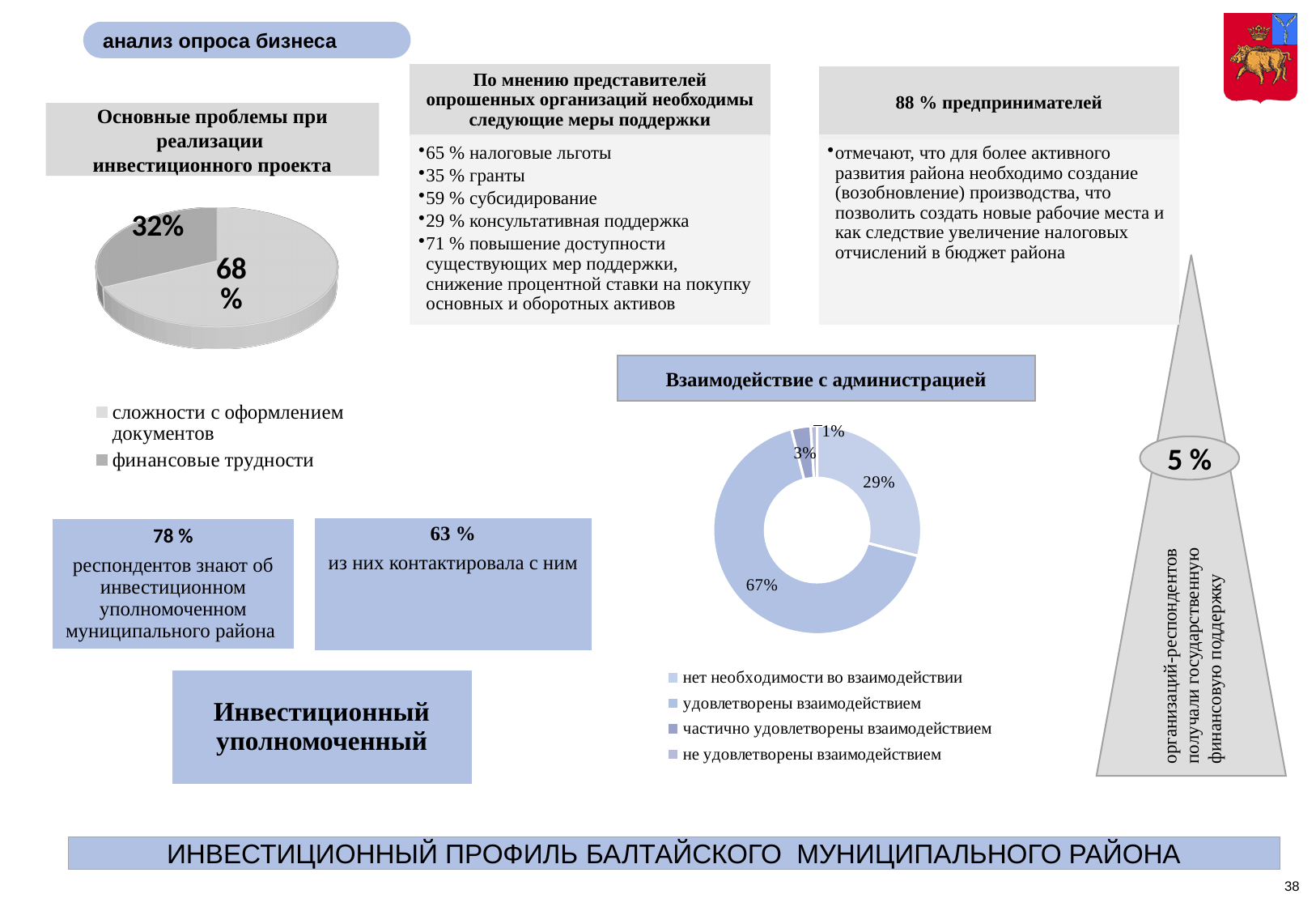
In the pie chart under 'Основные проблемы при реализации инвестиционного проекта', what share is labelled for 'сложности с оформлением документов'? 68% How many slices does the pie chart under 'Основные проблемы при реализации инвестиционного проекта' have? 2 How many categories does the legend of the 'Взаимодействие с администрацией' chart list? 4 In the 'Взаимодействие с администрацией' chart, what percentage is shown for 'нет необходимости во взаимодействии'? 29% In the 'Взаимодействие с администрацией' chart, what percentage is shown for 'частично удовлетворены взаимодействием'? 3% In the 'Взаимодействие с администрацией' chart, what percentage is shown for 'удовлетворены взаимодействием'? 67% In the pie chart under 'Основные проблемы при реализации инвестиционного проекта', what share is labelled for 'финансовые трудности'? 32% What type of chart is shown under 'Взаимодействие с администрацией'? doughnut chart In the 'Взаимодействие с администрацией' chart, which category has the smallest share? не удовлетворены взаимодействием In the pie chart under 'Основные проблемы при реализации инвестиционного проекта', what is the difference between the two slices' percentages? 36% In the 'Взаимодействие с администрацией' chart, which is larger: 'нет необходимости во взаимодействии' or 'удовлетворены взаимодействием'? удовлетворены взаимодействием In the pie chart under 'Основные проблемы при реализации инвестиционного проекта', which category has the largest share? сложности с оформлением документов